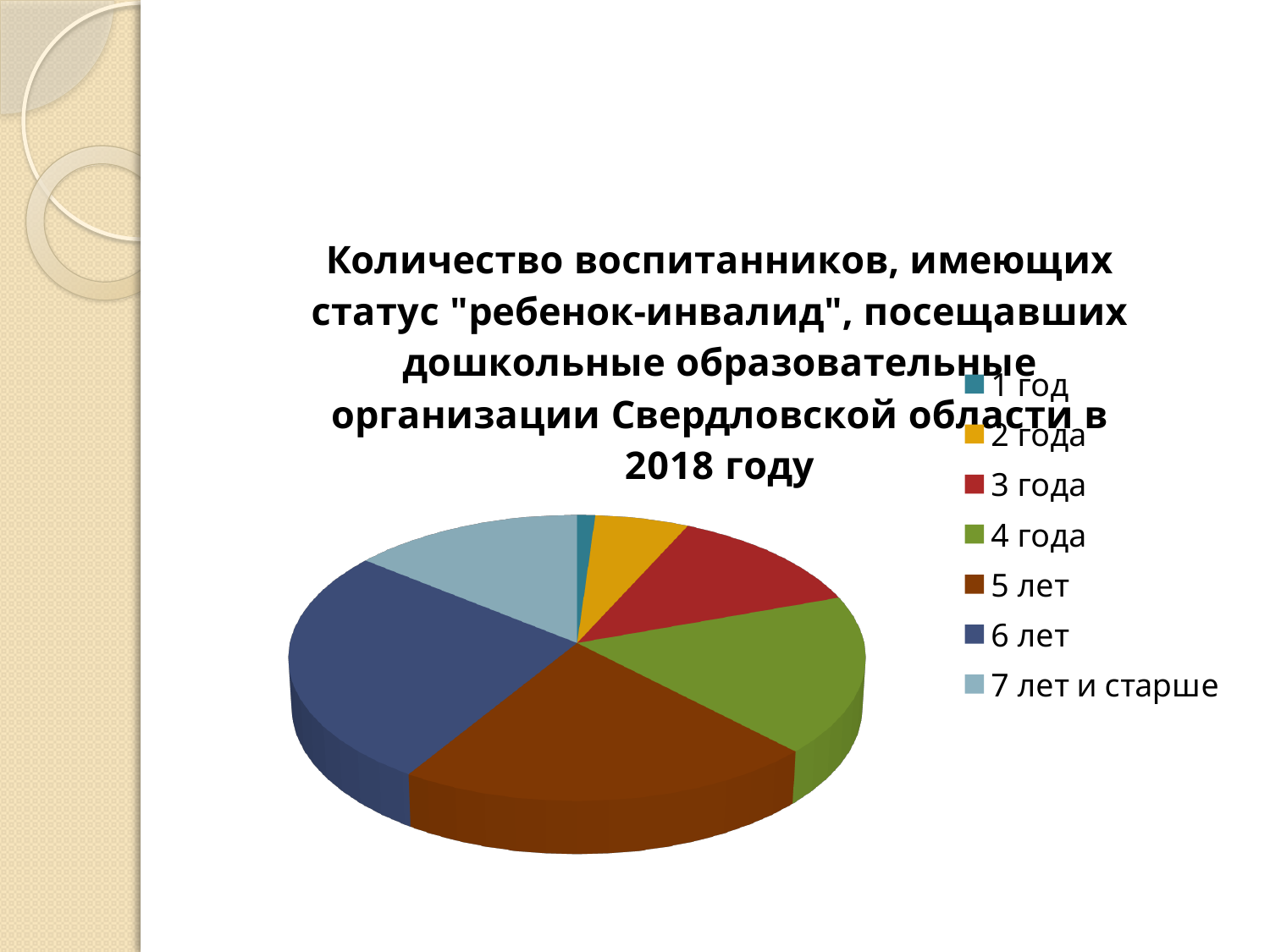
Which slice is larger: 6 лет or 1 год? 6 лет What colour is the slice for 5 лет in the legend? Brown Which slice is larger: 7 лет и старше or 2 года? 7 лет и старше What kind of chart is shown on the slide? Pie chart Which age group has the smallest slice of the pie? 1 год Which slice is larger: 3 года or 2 года? 3 года Which age group has the largest slice of the pie? 6 лет Which year does the chart title refer to? 2018 How many categories (age groups) does the pie chart show? 7